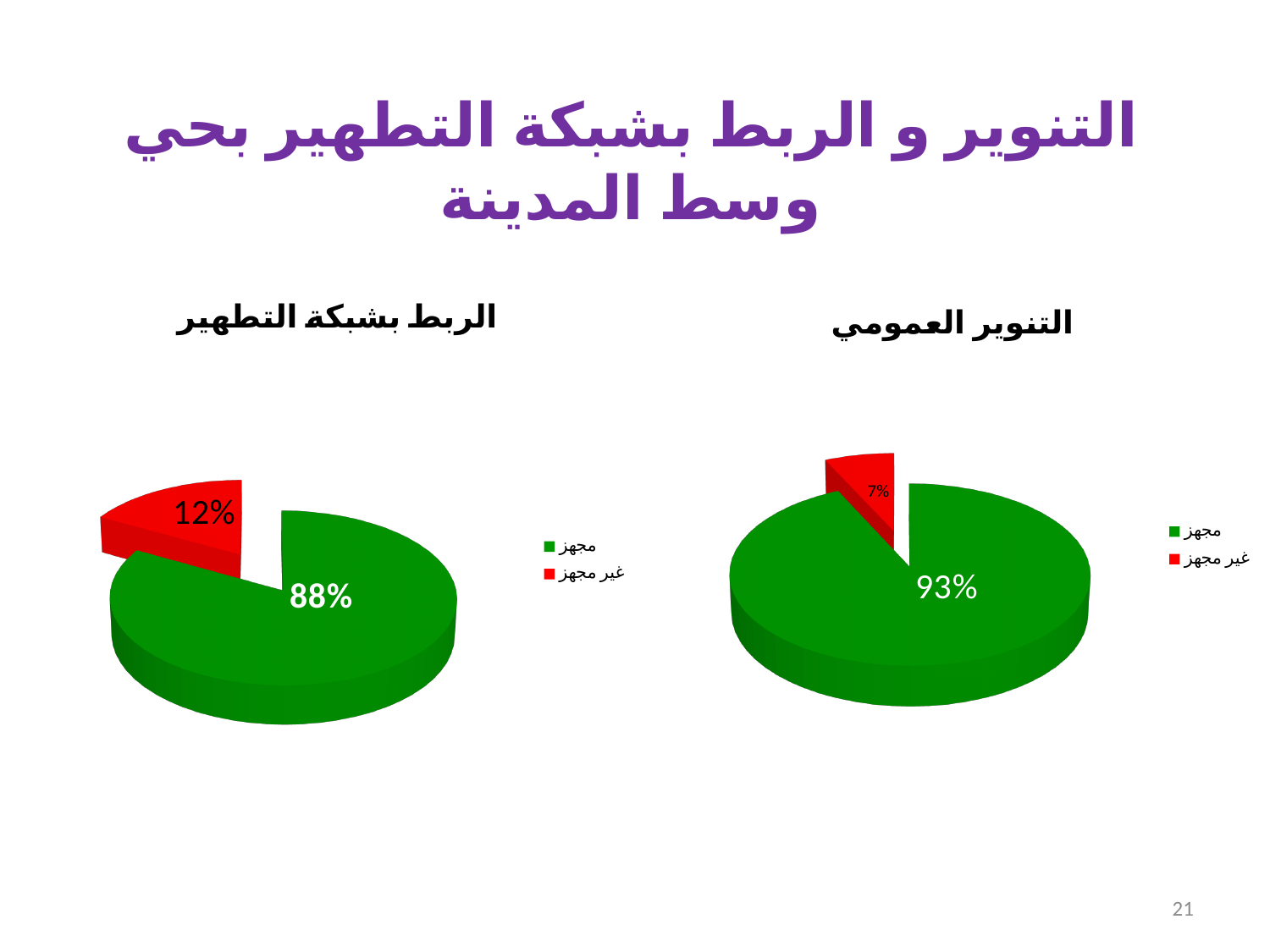
How many slices does the left chart (الربط بشبكة التطهير) have? 2 In the chart titled التنوير العمومي (right), what share is labelled for the مجهز slice? 93% In the chart titled الربط بشبكة التطهير (left), what share is labelled for the مجهز slice? 88% In the left chart (الربط بشبكة التطهير), what is the difference between the مجهز and غير مجهز shares? 76% In the left chart (الربط بشبكة التطهير), which category has the largest slice? مجهز Which chart shows a larger share for غير مجهز: the left chart (الربط بشبكة التطهير) or the right chart (التنوير العمومي)? the left chart (الربط بشبكة التطهير) In the right chart (التنوير العمومي), which category has the smallest slice? غير مجهز How many entries does the legend of the right chart (التنوير العمومي) list? 2 In the chart titled التنوير العمومي (right), what share is labelled for the غير مجهز slice? 7% In the chart titled الربط بشبكة التطهير (left), what share is labelled for the غير مجهز slice? 12% What type of chart is used for التنوير العمومي on the right? pie chart In the right chart (التنوير العمومي), what colour is the مجهز slice? green